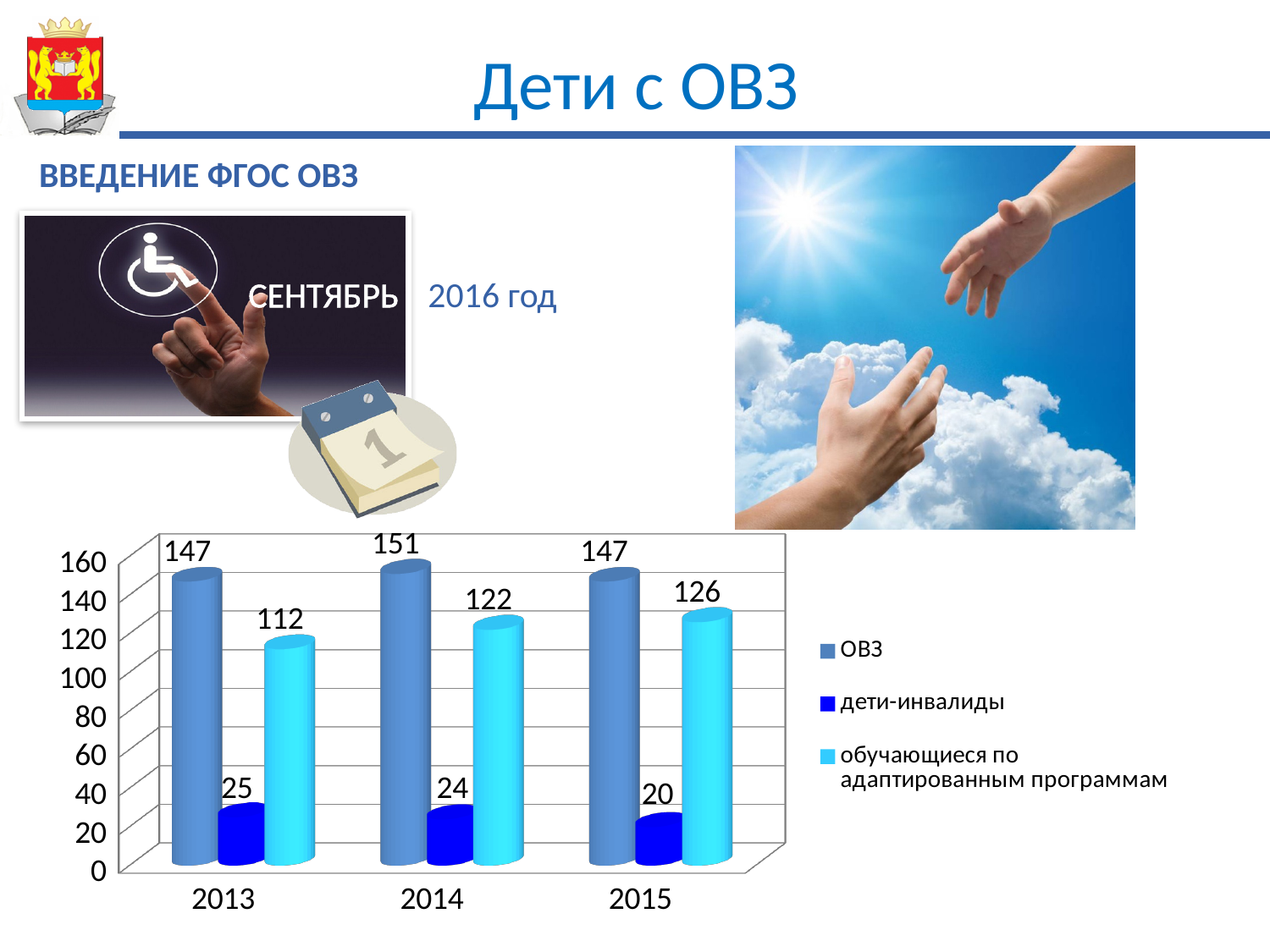
What is the value for обучающиеся по адаптированным программам in 2013? 112 In which year is the value for ОВЗ highest? 2014 In which year is the value for дети-инвалиды lowest? 2015 Does the value for обучающиеся по адаптированным программам rise or fall from 2013 to 2015? rise What is the value for дети-инвалиды in 2015? 20 What is the difference between the ОВЗ value and the обучающиеся по адаптированным программам value in 2015? 21 Which is larger in 2014: the value for обучающиеся по адаптированным программам or the value for дети-инвалиды? обучающиеся по адаптированным программам What is the value for ОВЗ in 2014? 151 How many years are shown on the x axis of the chart? 3 What kind of chart is shown on the slide? bar chart What is the difference between the дети-инвалиды values in 2013 and 2015? 5 How many series does the chart legend list? 3